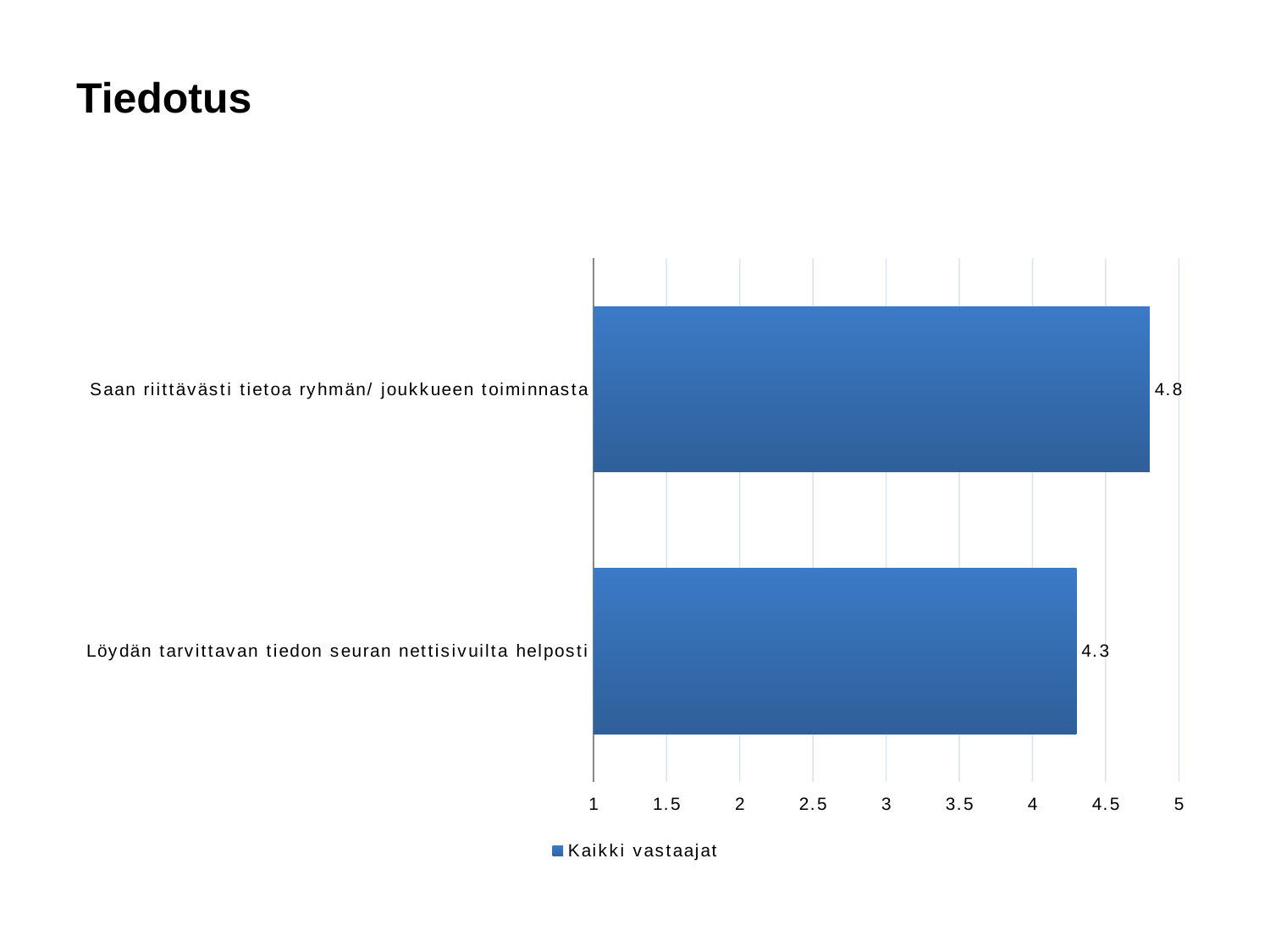
Which is larger: the value for "Saan riittävästi tietoa ryhmän/ joukkueen toiminnasta" or for "Löydän tarvittavan tiedon seuran nettisivuilta helposti"? Saan riittävästi tietoa ryhmän/ joukkueen toiminnasta What is the value for "Löydän tarvittavan tiedon seuran nettisivuilta helposti"? 4.3 Is the value for "Saan riittävästi tietoa ryhmän/ joukkueen toiminnasta" greater or less than 4.5? greater How many series does the legend list? 1 Is the value for "Löydän tarvittavan tiedon seuran nettisivuilta helposti" greater or less than 4? greater Which category has the lowest value? Löydän tarvittavan tiedon seuran nettisivuilta helposti What kind of chart is shown on the slide? bar chart What is the value for "Saan riittävästi tietoa ryhmän/ joukkueen toiminnasta"? 4.8 What is the name of the series shown in the legend? Kaikki vastaajat Which category has the highest value? Saan riittävästi tietoa ryhmän/ joukkueen toiminnasta How many categories are shown in the chart? 2 What is the difference between the values for "Saan riittävästi tietoa ryhmän/ joukkueen toiminnasta" and "Löydän tarvittavan tiedon seuran nettisivuilta helposti"? 0.5